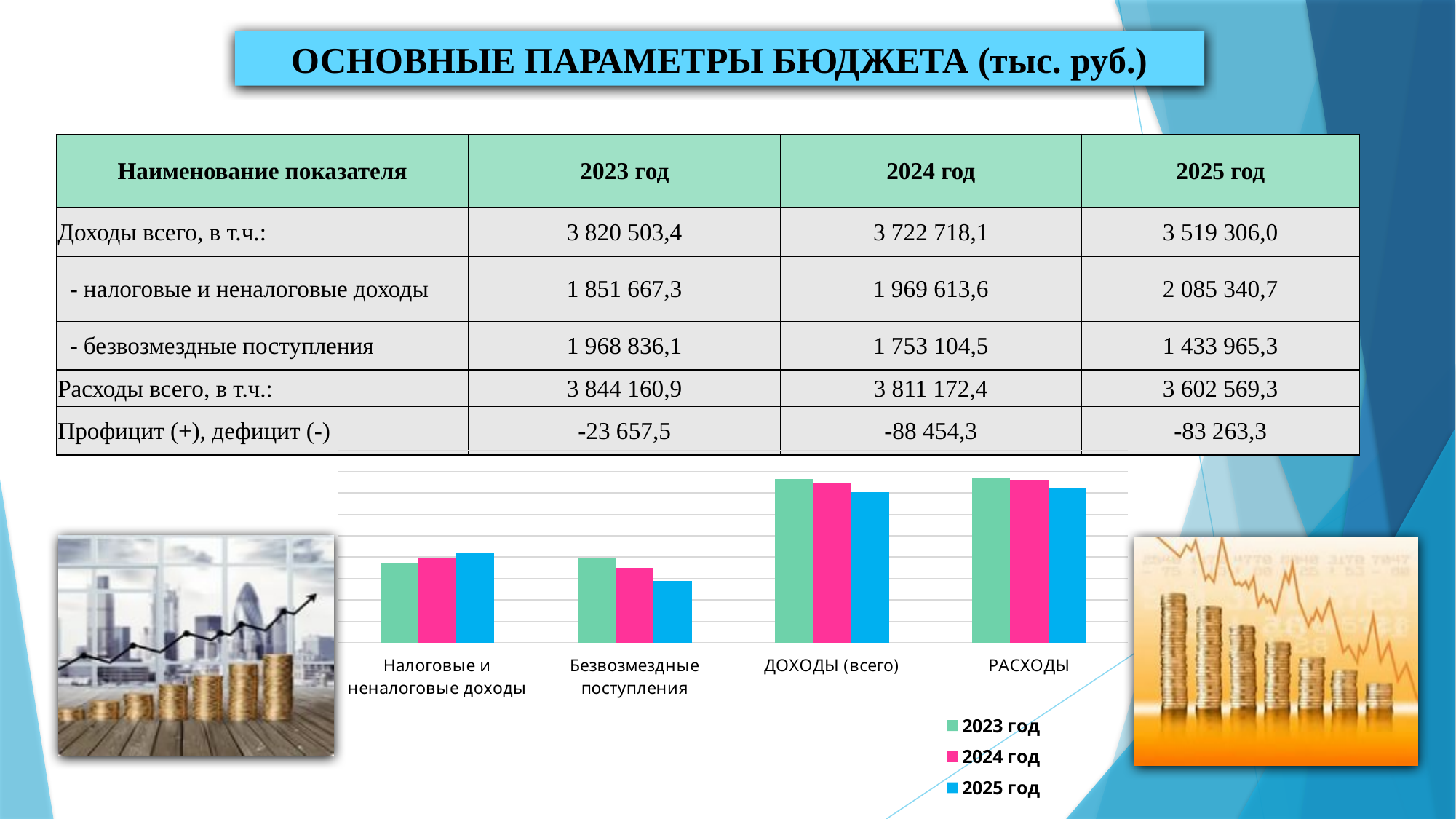
In the bar chart, which is larger for 2023 год: 'Безвозмездные поступления' or 'Налоговые и неналоговые доходы'? Безвозмездные поступления In the bar chart, do the bars for 'Безвозмездные поступления' rise or fall from 2023 год to 2025 год? fall In the bar chart, which category has the lowest bar for the 2023 год series? Налоговые и неналоговые доходы Which series in the bar chart is shown in blue? 2025 год How many categories are shown on the x axis of the bar chart? 4 In the bar chart, which is larger for 2025 год: 'Налоговые и неналоговые доходы' or 'Безвозмездные поступления'? Налоговые и неналоговые доходы What kind of chart is shown at the bottom of the slide? bar chart In the bar chart, do the bars for 'Налоговые и неналоговые доходы' rise or fall from 2023 год to 2025 год? rise In the bar chart, which category has the lowest bar for the 2025 год series? Безвозмездные поступления Which series in the bar chart is shown in green? 2023 год In the bar chart, do the bars for 'ДОХОДЫ (всего)' rise or fall from 2023 год to 2025 год? fall How many series does the legend of the bar chart list? 3